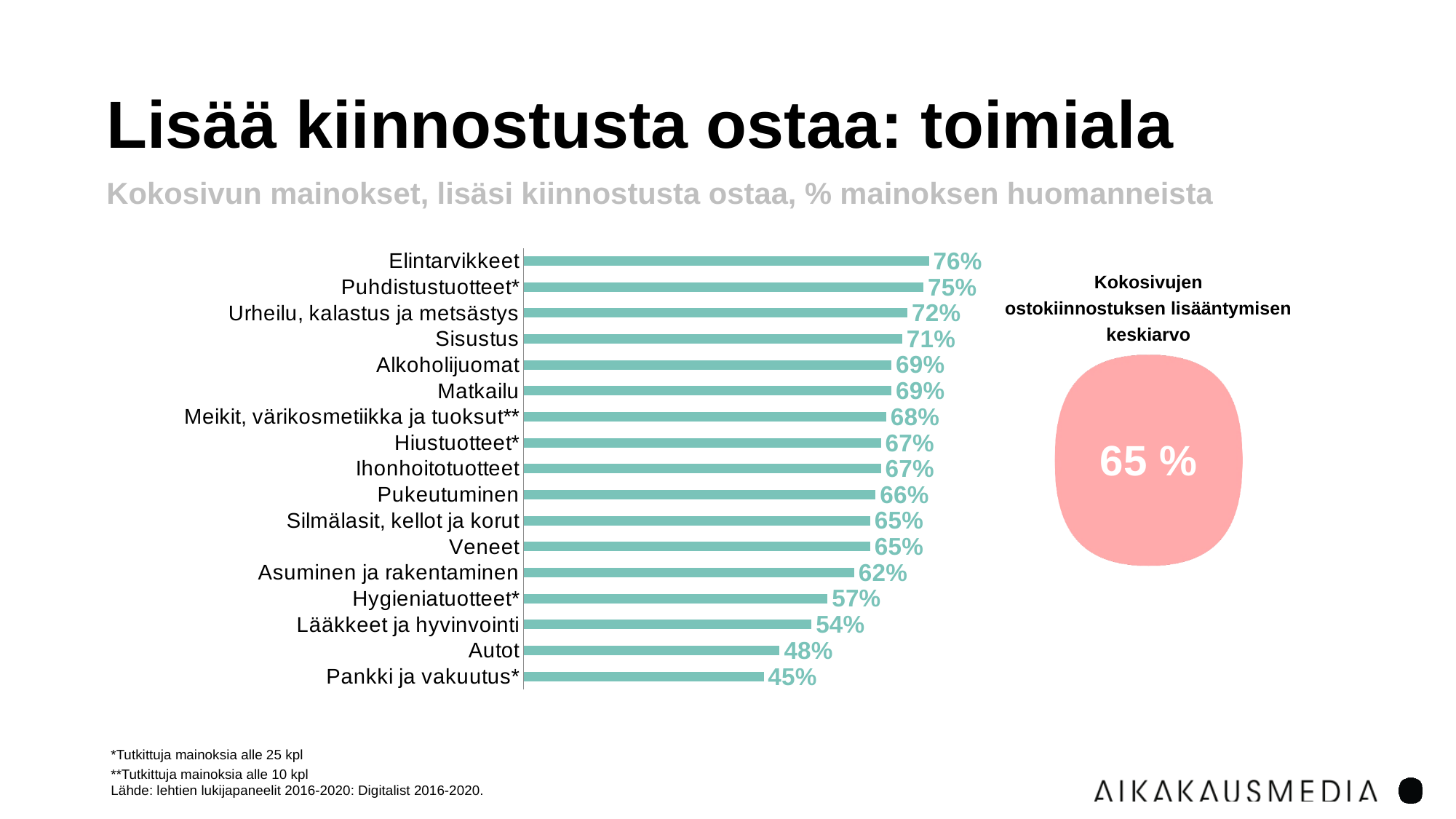
What is the value for Autot? 48% What is the value for Asuminen ja rakentaminen? 62% What average value is shown in the pink circle next to the chart? 65 % What kind of chart is shown on the slide? Bar chart Which is larger, the value for Matkailu or the value for Lääkkeet ja hyvinvointi? Matkailu What is the difference between the values for Elintarvikkeet and Pankki ja vakuutus*? 31 percentage points What is the value for Pankki ja vakuutus*? 45% Which category has the highest value? Elintarvikkeet How many categories are shown in the bar chart? 17 What is the difference between the values for Sisustus and Hygieniatuotteet*? 14 percentage points Which category has the lowest value? Pankki ja vakuutus* What is the value for Elintarvikkeet? 76%